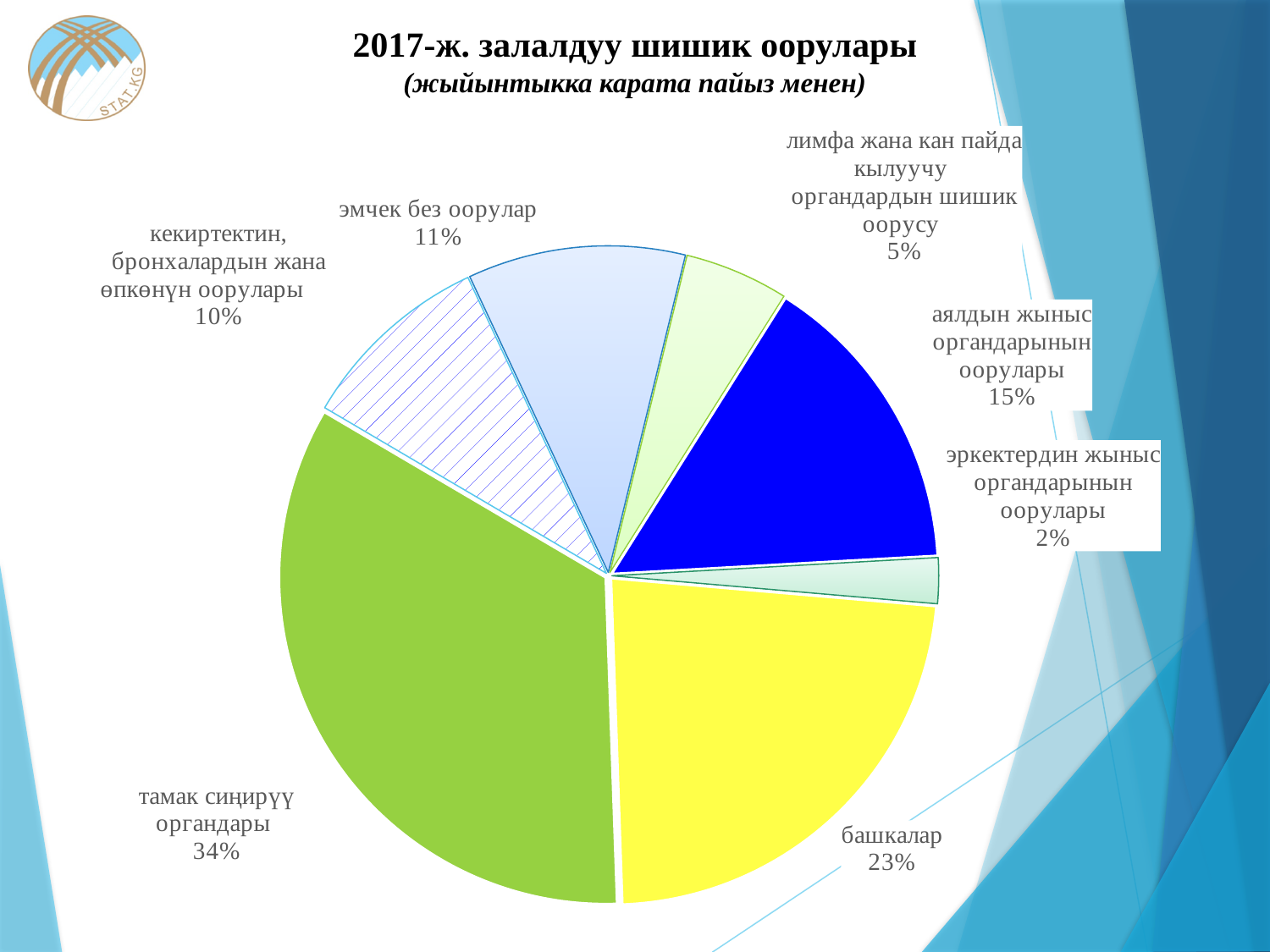
Which is larger: the share for эмчек без оорулар or the share for лимфа жана кан пайда кылуучу органдардын шишик оорусу? эмчек без оорулар What is the value for эркектердин жыныс органдарынын оорулары? 2% What is the value for эмчек без оорулар? 11% Which category has the smallest share of the pie? эркектердин жыныс органдарынын оорулары What is the difference in percentage points between тамак сиңирүү органдары and башкалар? 11 What kind of chart is shown on the slide? pie chart Which category has the largest share of the pie? тамак сиңирүү органдары How many categories are shown in the pie chart? 7 What percentage is shown for кекиртектин, бронхалардын жана өпкөнүн оорулары? 10% What is the value shown for башкалар? 23% What percentage is shown for аялдын жыныс органдарынын оорулары? 15% What share of the pie does тамак сиңирүү органдары account for? 34%